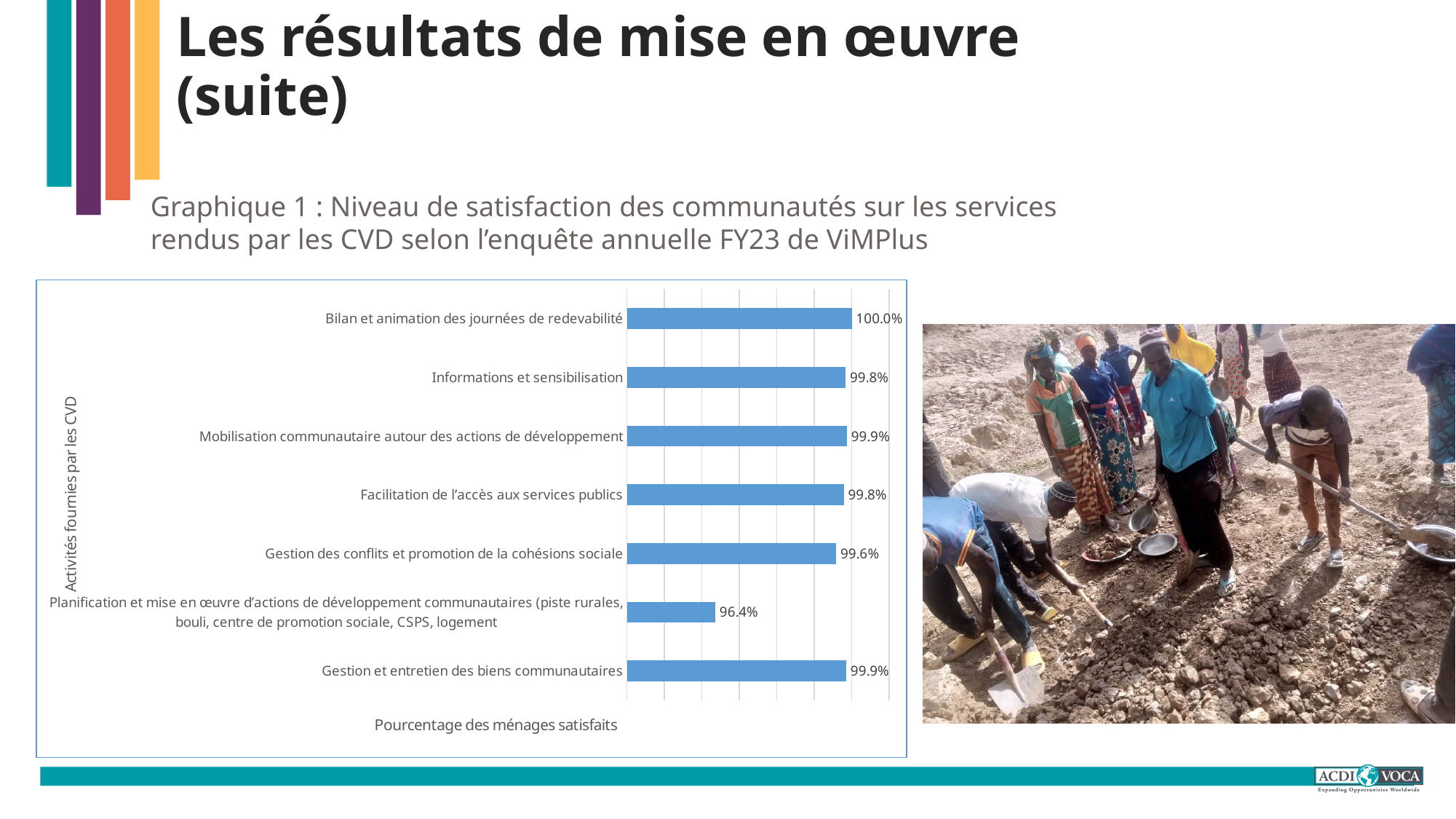
What is the value shown for "Gestion et entretien des biens communautaires"? 99.9% What is the value shown for "Gestion des conflits et promotion de la cohésions sociale"? 99.6% Which activity has the highest percentage of satisfied households? Bilan et animation des journées de redevabilité Which is larger: the value for "Gestion des conflits et promotion de la cohésions sociale" or the value for "Planification et mise en œuvre d'actions de développement communautaires"? Gestion des conflits et promotion de la cohésions sociale Which activity has the lowest percentage of satisfied households? Planification et mise en œuvre d'actions de développement communautaires (piste rurales, bouli, centre de promotion sociale, CSPS, logement What kind of chart is shown on the slide? Bar chart What is the difference between the value for "Bilan et animation des journées de redevabilité" and the value for "Planification et mise en œuvre d'actions de développement communautaires"? 3.6% What is the label of the horizontal axis of the chart? Pourcentage des ménages satisfaits What is the difference between the value for "Informations et sensibilisation" and the value for "Gestion des conflits et promotion de la cohésions sociale"? 0.2% How many activities (categories) are plotted in the chart? 7 What is the value shown for "Planification et mise en œuvre d'actions de développement communautaires (piste rurales, bouli, centre de promotion sociale, CSPS, logement"? 96.4% What is the satisfaction value for "Bilan et animation des journées de redevabilité"? 100.0%